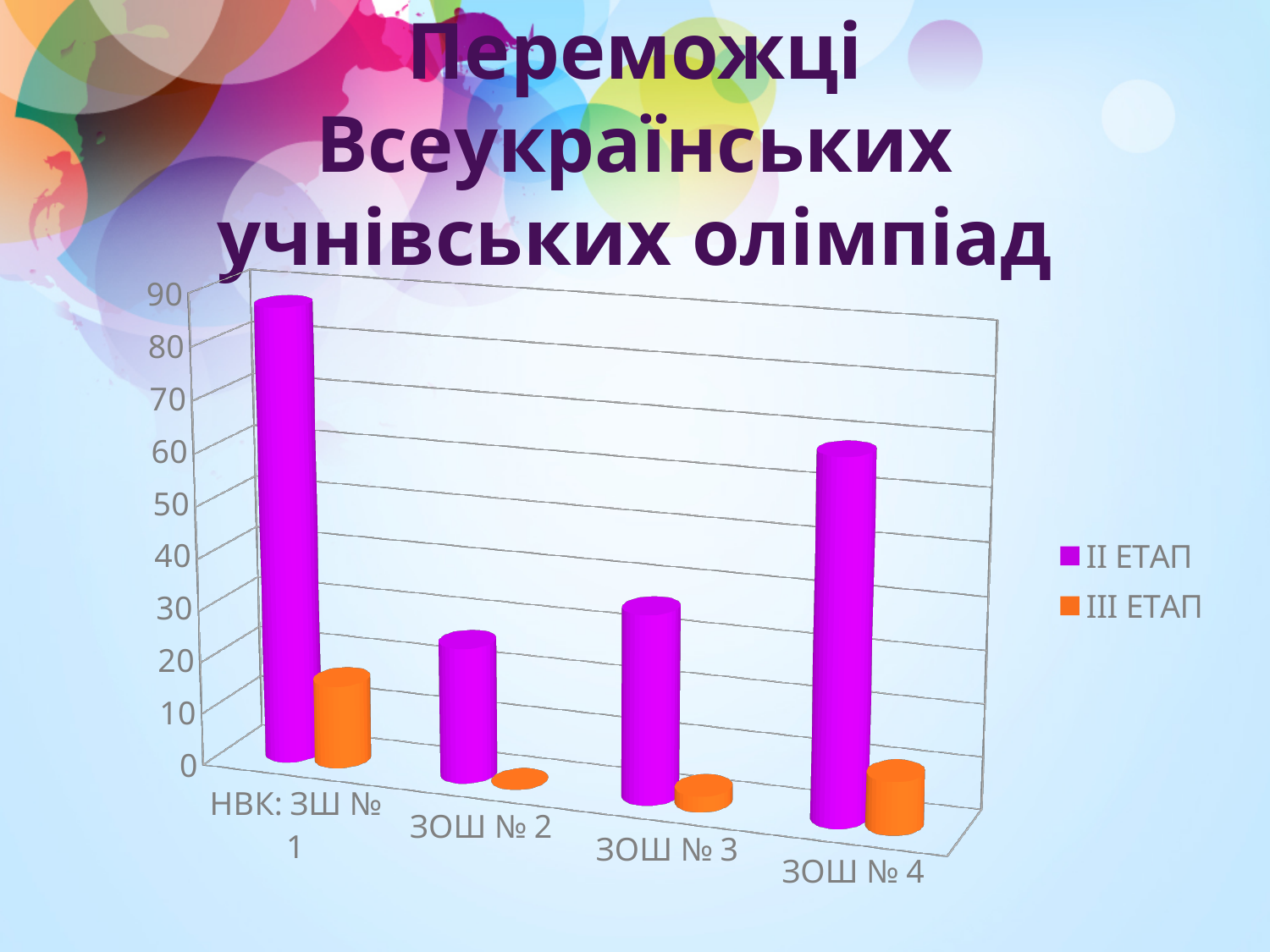
What kind of chart is shown on the slide? bar chart Which category has the lowest value for III ЕТАП? ЗОШ № 2 Is the II ЕТАП value for ЗОШ № 2 greater or less than 40? less For II ЕТАП, which is larger: ЗОШ № 3 or ЗОШ № 4? ЗОШ № 4 Is the II ЕТАП value for НВК: ЗШ № 1 greater or less than 70? greater How many categories (schools) are shown on the x axis of the chart? 4 Which category has the lowest value for II ЕТАП? ЗОШ № 2 Which category has the highest value for III ЕТАП? НВК: ЗШ № 1 Which category has the highest value for II ЕТАП? НВК: ЗШ № 1 Is the II ЕТАП value for ЗОШ № 4 greater or less than 40? greater What are the two series named in the chart's legend? II ЕТАП and III ЕТАП How many series does the chart's legend list? 2